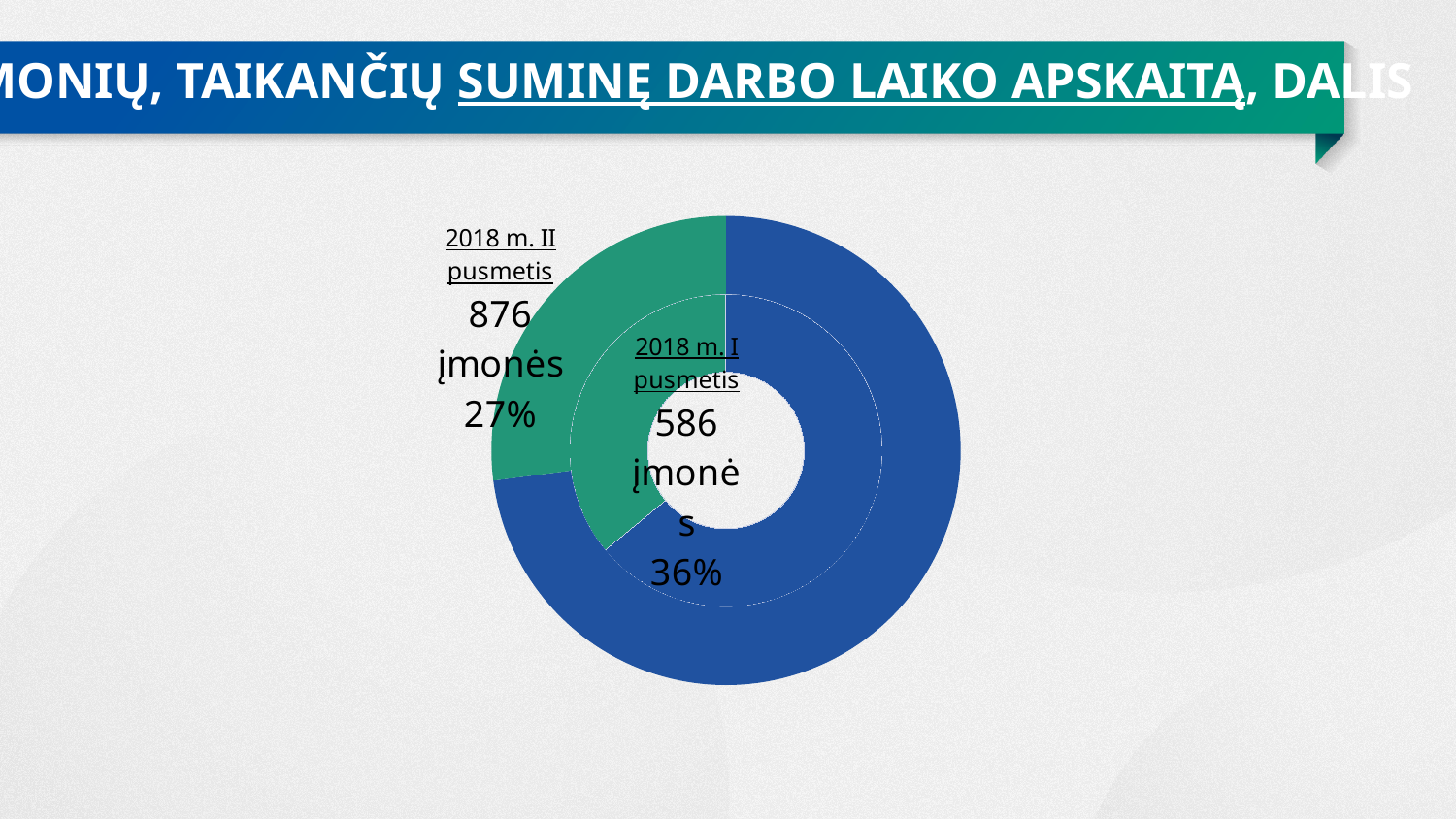
What colour is used for the labelled share segments in the chart? green Which period has the larger percentage share, 2018 m. I pusmetis or 2018 m. II pusmetis? 2018 m. I pusmetis What percentage is shown for 2018 m. I pusmetis? 36% Which period is shown on the inner ring of the doughnut chart? 2018 m. I pusmetis What is the difference in the number of companies between 2018 m. II pusmetis and 2018 m. I pusmetis? 290 Which period has the larger number of companies, 2018 m. I pusmetis or 2018 m. II pusmetis? 2018 m. II pusmetis What type of chart is shown on the slide? doughnut chart How many companies are shown for 2018 m. I pusmetis? 586 įmonės How many companies are shown for 2018 m. II pusmetis? 876 įmonės By how many percentage points does the share for 2018 m. I pusmetis exceed the share for 2018 m. II pusmetis? 9 What percentage is shown for 2018 m. II pusmetis? 27% How many rings (periods) does the doughnut chart show? 2